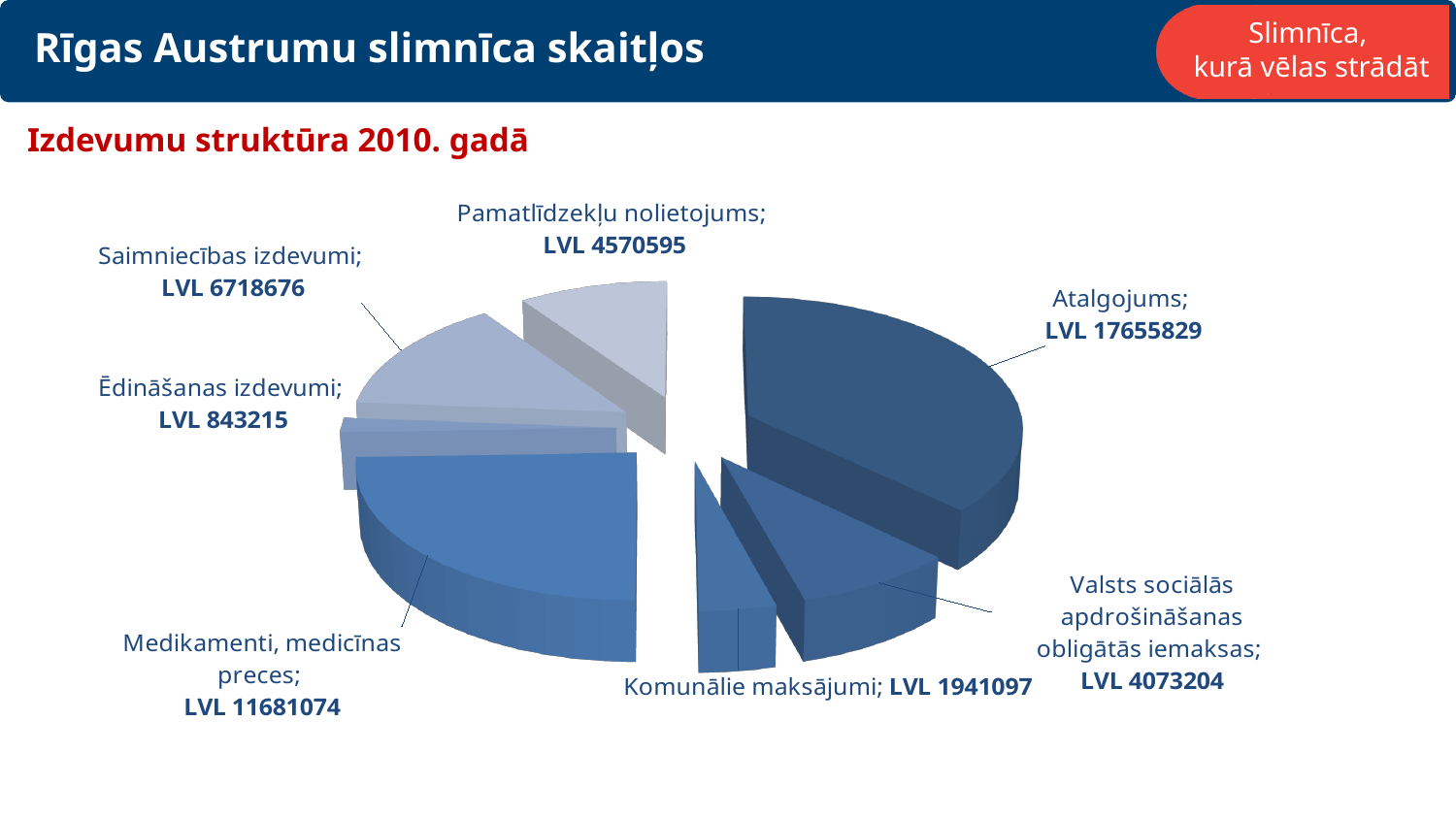
What is the difference between Atalgojums and Medikamenti, medicīnas preces? LVL 5974755 What is the value for Komunālie maksājumi? LVL 1941097 How many slices does the pie chart have? 7 Which category has the smallest value? Ēdināšanas izdevumi What is the difference between Saimniecības izdevumi and Pamatlīdzekļu nolietojums? LVL 2148081 Which is larger, Saimniecības izdevumi or Pamatlīdzekļu nolietojums? Saimniecības izdevumi What is the value for Valsts sociālās apdrošināšanas obligātās iemaksas? LVL 4073204 What is the value for Atalgojums? LVL 17655829 What is the title of the chart? Izdevumu struktūra 2010. gadā What kind of chart is shown on the slide? Pie chart What is the value for Medikamenti, medicīnas preces? LVL 11681074 Which category has the largest value? Atalgojums